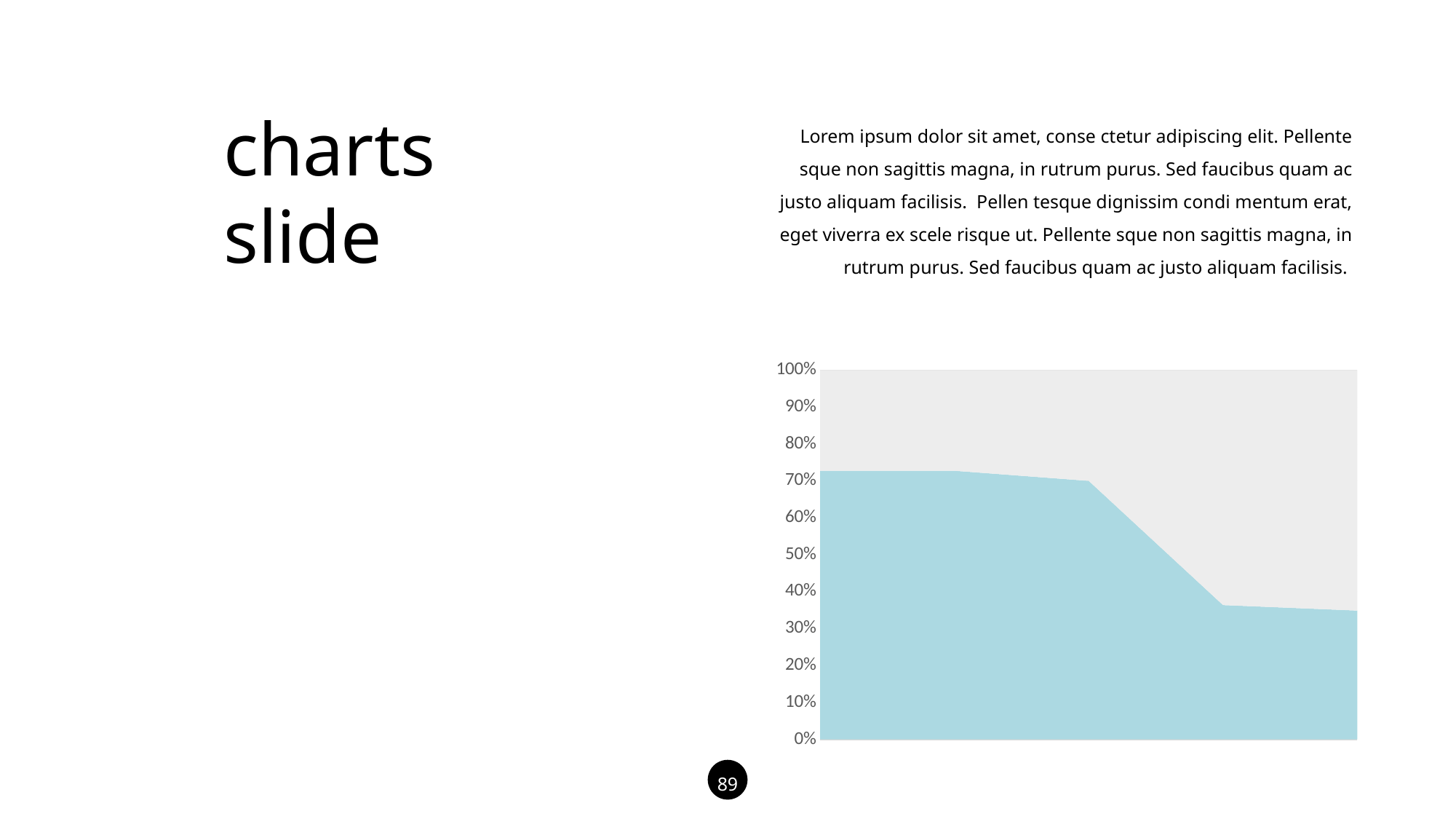
What is the highest value shown on the y axis of the area chart? 100% Is the value at the rightmost point of the area chart greater or less than 40%? less Is the value at the rightmost point of the area chart greater or less than 30%? greater Is the value at the leftmost point of the area chart greater or less than 60%? greater Do the values in the area chart rise or fall from left to right along the x axis? fall Which is larger in the area chart, the value at the leftmost point or the value at the rightmost point? the leftmost point What kind of chart is shown on the slide? area chart What colour is the filled area in the chart? light blue